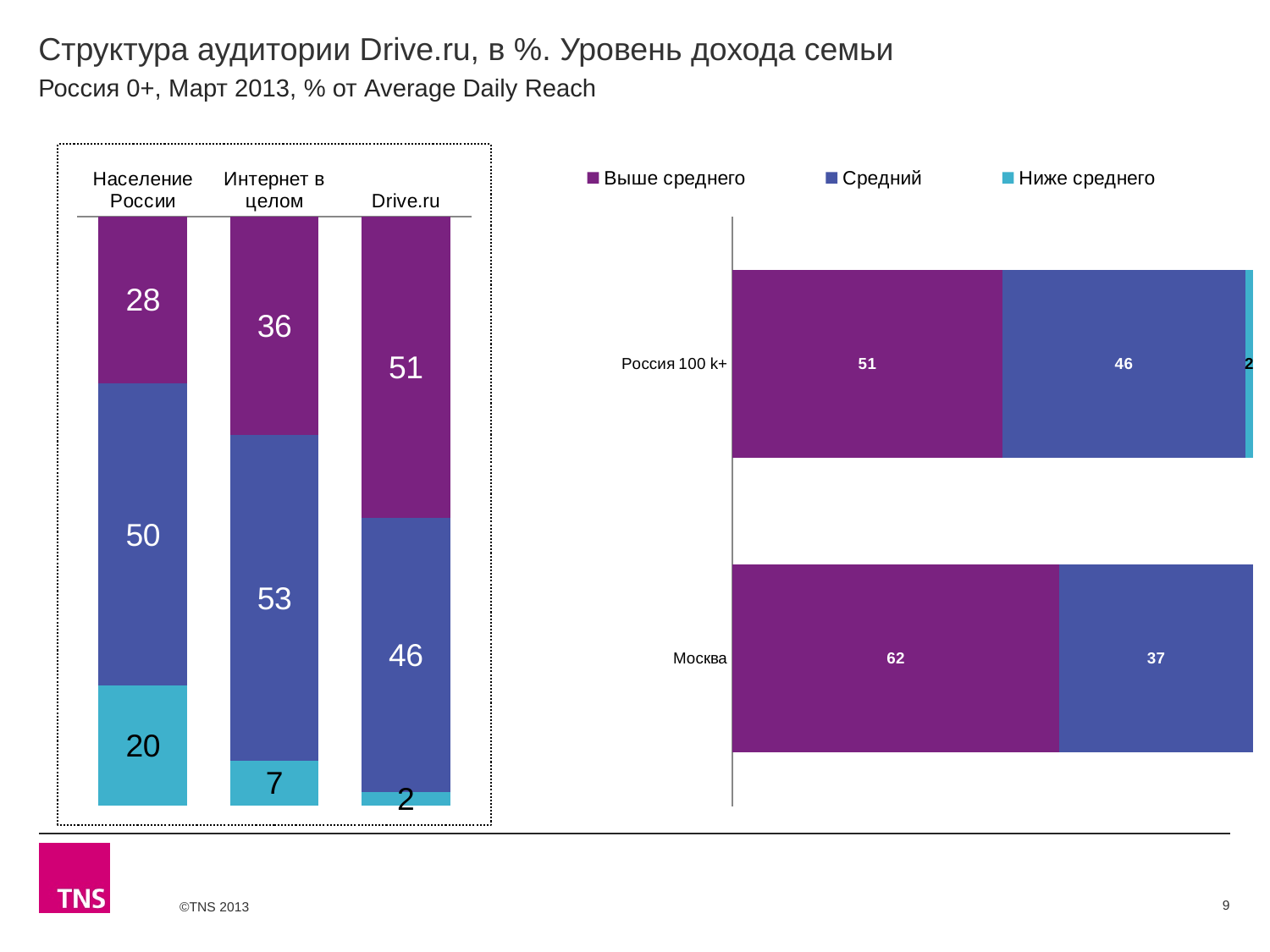
In the right chart, what is the 'Средний' value for Россия 100 k+? 46 In the left chart, what is the 'Выше среднего' value for Drive.ru? 51 What type of chart is the right chart? Stacked bar chart In the left chart, what is the 'Ниже среднего' value for Население России? 20 In the left chart, what is the 'Средний' value for Интернет в целом? 53 How many series does the legend list? 3 In the left chart, what is the difference between the 'Выше среднего' values for Drive.ru and Население России? 23 In the right chart, what is the 'Выше среднего' value for Москва? 62 In the left chart, which category has the lowest 'Ниже среднего' value? Drive.ru In the right chart, which has a larger 'Средний' value: Россия 100 k+ or Москва? Россия 100 k+ How many categories are shown in the left chart? 3 In the left chart, which category has the highest 'Выше среднего' value? Drive.ru